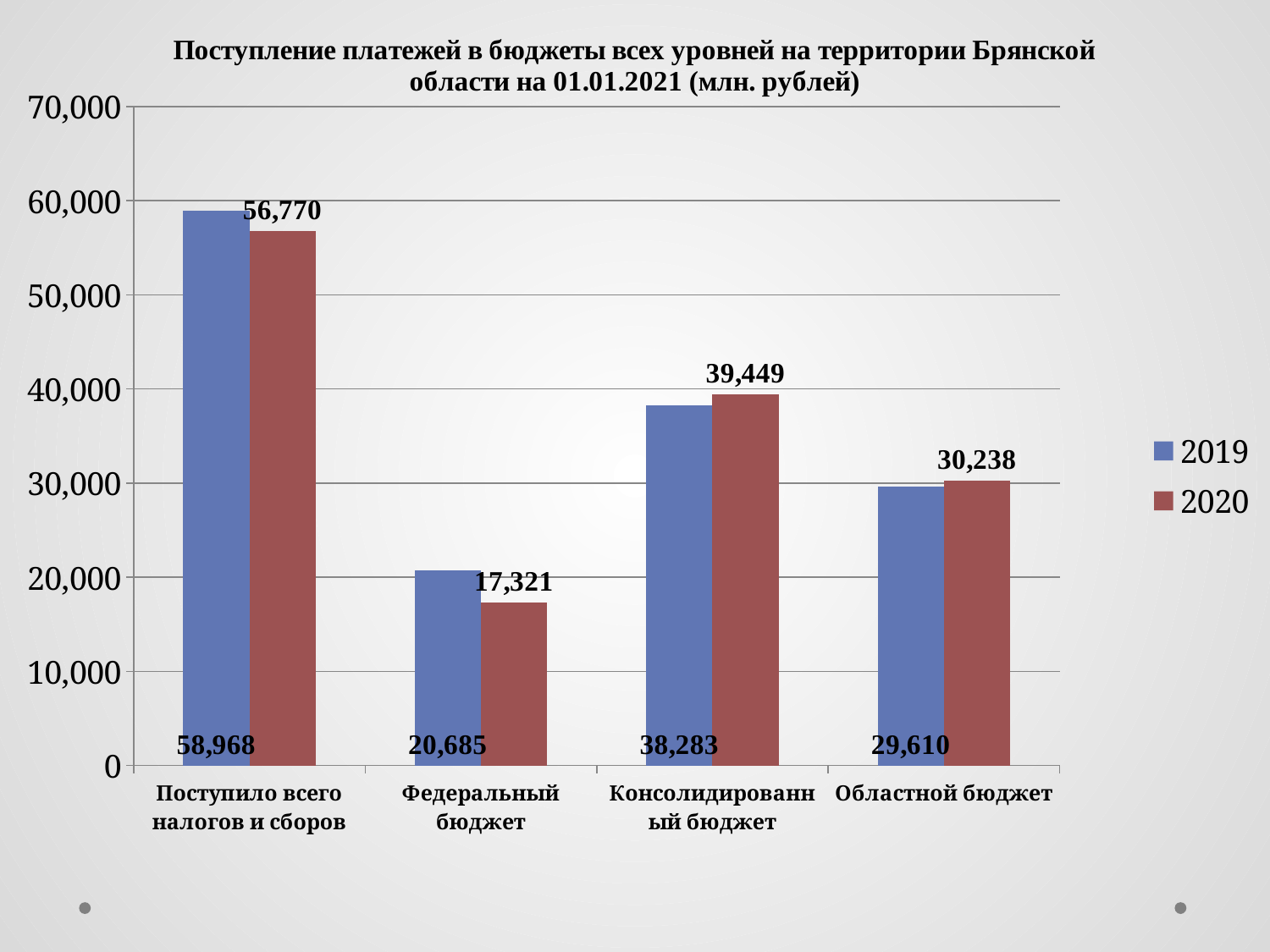
What is the difference between the 2019 and 2020 values for Поступило всего налогов и сборов? 2,198 What is the 2019 value for Поступило всего налогов и сборов? 58,968 Which category has the highest 2019 value? Поступило всего налогов и сборов How many series does the legend list? 2 Which is larger for Консолидированный бюджет: the 2019 value or the 2020 value? 2020 What is the 2020 value for Федеральный бюджет? 17,321 Is the 2019 value for Федеральный бюджет greater or less than 20,000? greater What is the 2020 value for Областной бюджет? 30,238 What is the 2019 value for Консолидированный бюджет? 38,283 How many categories are shown on the x axis? 4 Which category has the lowest 2020 value? Федеральный бюджет What kind of chart is shown on the slide? Bar chart